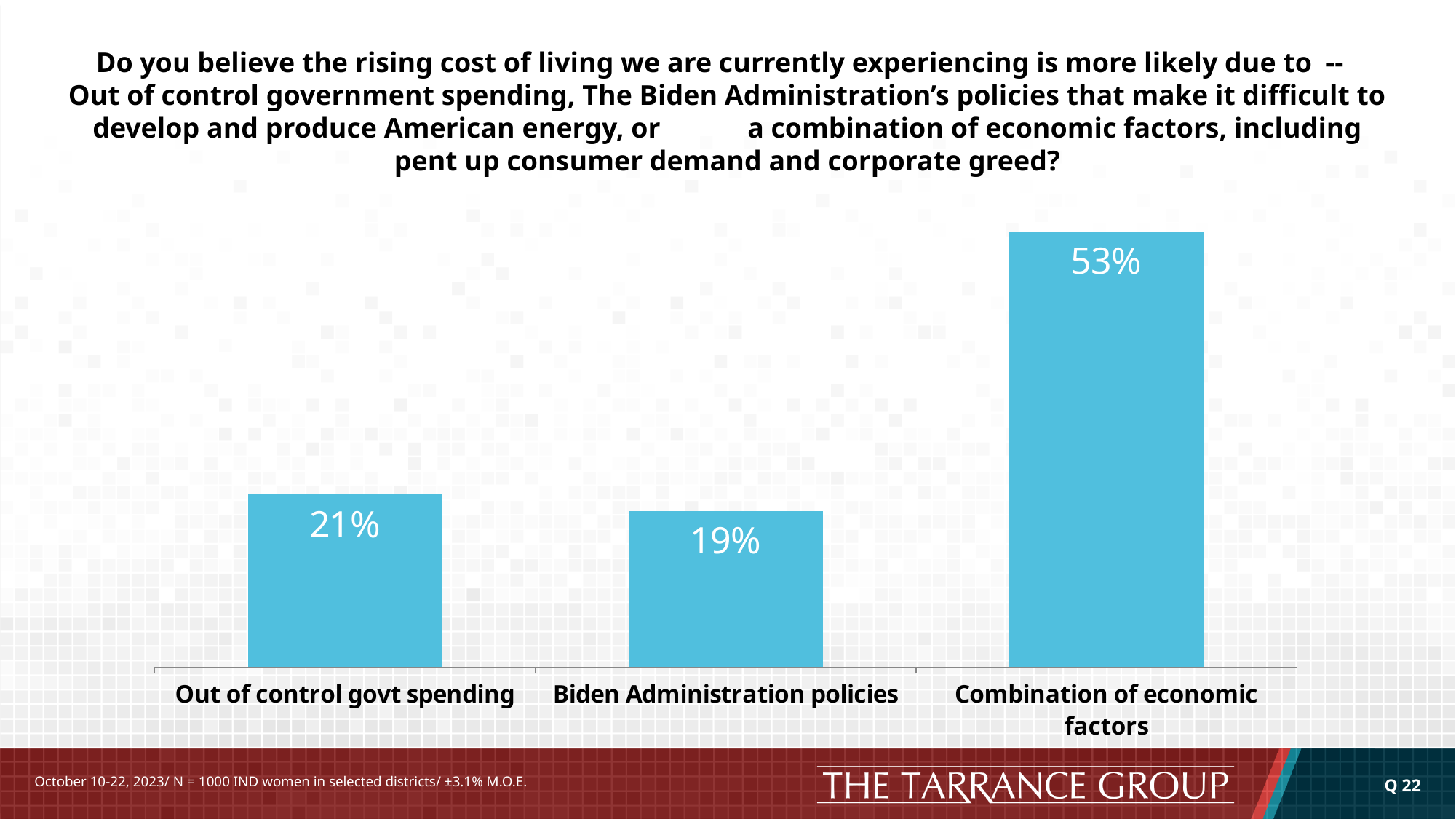
Which is larger: the value for out of control govt spending or the value for Biden Administration policies? Out of control govt spending What percentage chose a combination of economic factors? 53% Which category has the highest value? Combination of economic factors How many categories are shown in the chart? 3 Which category has the lowest value? Biden Administration policies What percentage of respondents attributed the rising cost of living to out of control govt spending? 21% What colour are the bars in the chart? Light blue What is the difference between the values for out of control govt spending and Biden Administration policies? 2 percentage points What type of chart is shown on the slide? Bar chart What is the sample size stated at the bottom of the slide? N = 1000 IND women in selected districts What is the difference between the value for combination of economic factors and the value for out of control govt spending? 32 percentage points What is the value shown for Biden Administration policies? 19%